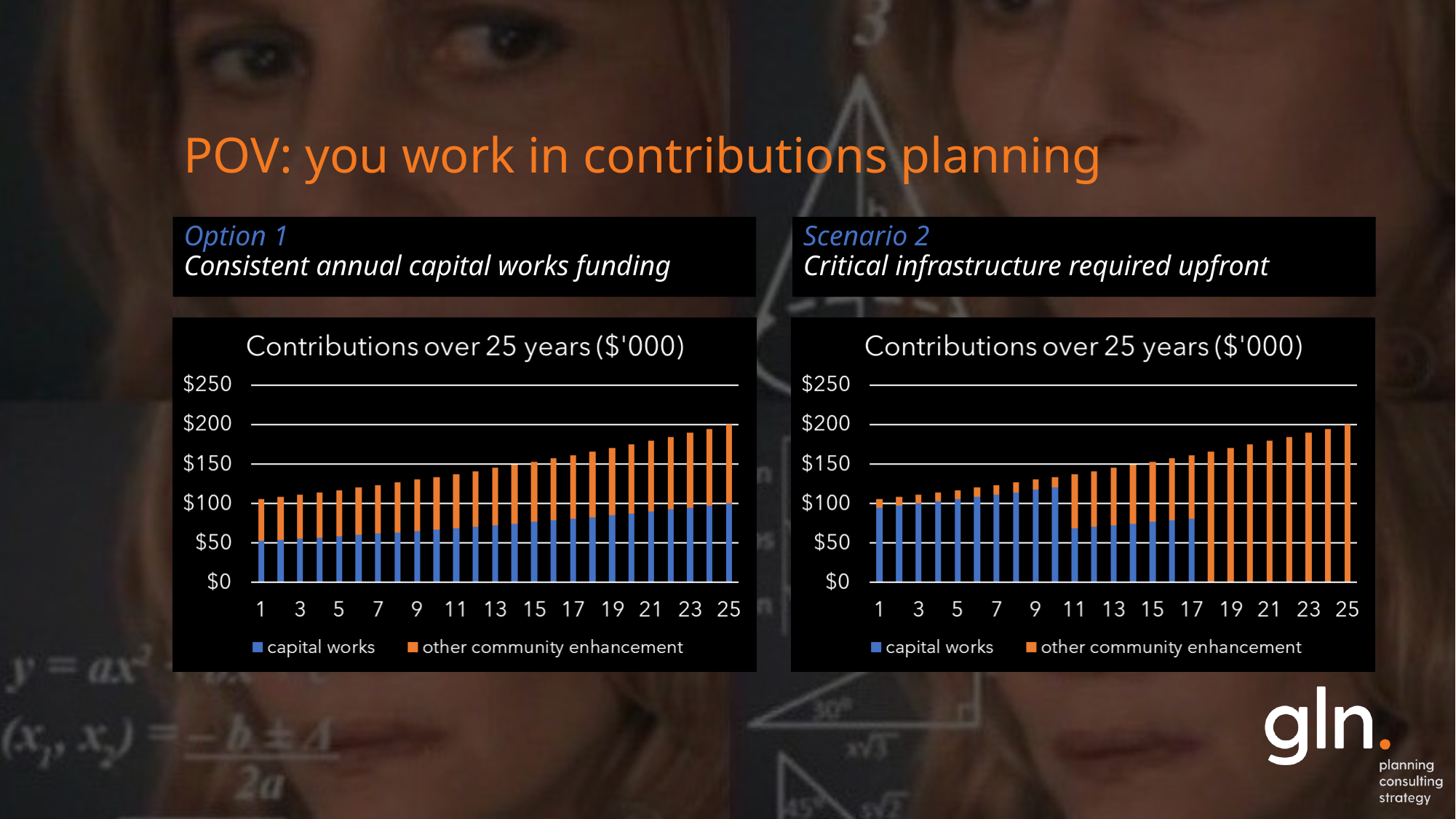
What are the two legend entries in the Option 1 chart? capital works; other community enhancement In the Option 1 chart, do the total contributions rise or fall from year 1 to year 25? Rise In the Option 1 chart, is the total contribution for year 13 greater or less than $150? less In the Scenario 2 chart, is the capital works value for year 10 greater or less than $100? greater In the Option 1 chart, is the capital works value for year 13 greater or less than $100? less How many series does the legend list in the Scenario 2 chart? 2 How many years (bars) are plotted in the Option 1 chart? 25 What kind of chart is the Option 1 chart 'Contributions over 25 years ($'000)'? Stacked bar chart What is the title of the Scenario 2 chart? Contributions over 25 years ($'000)